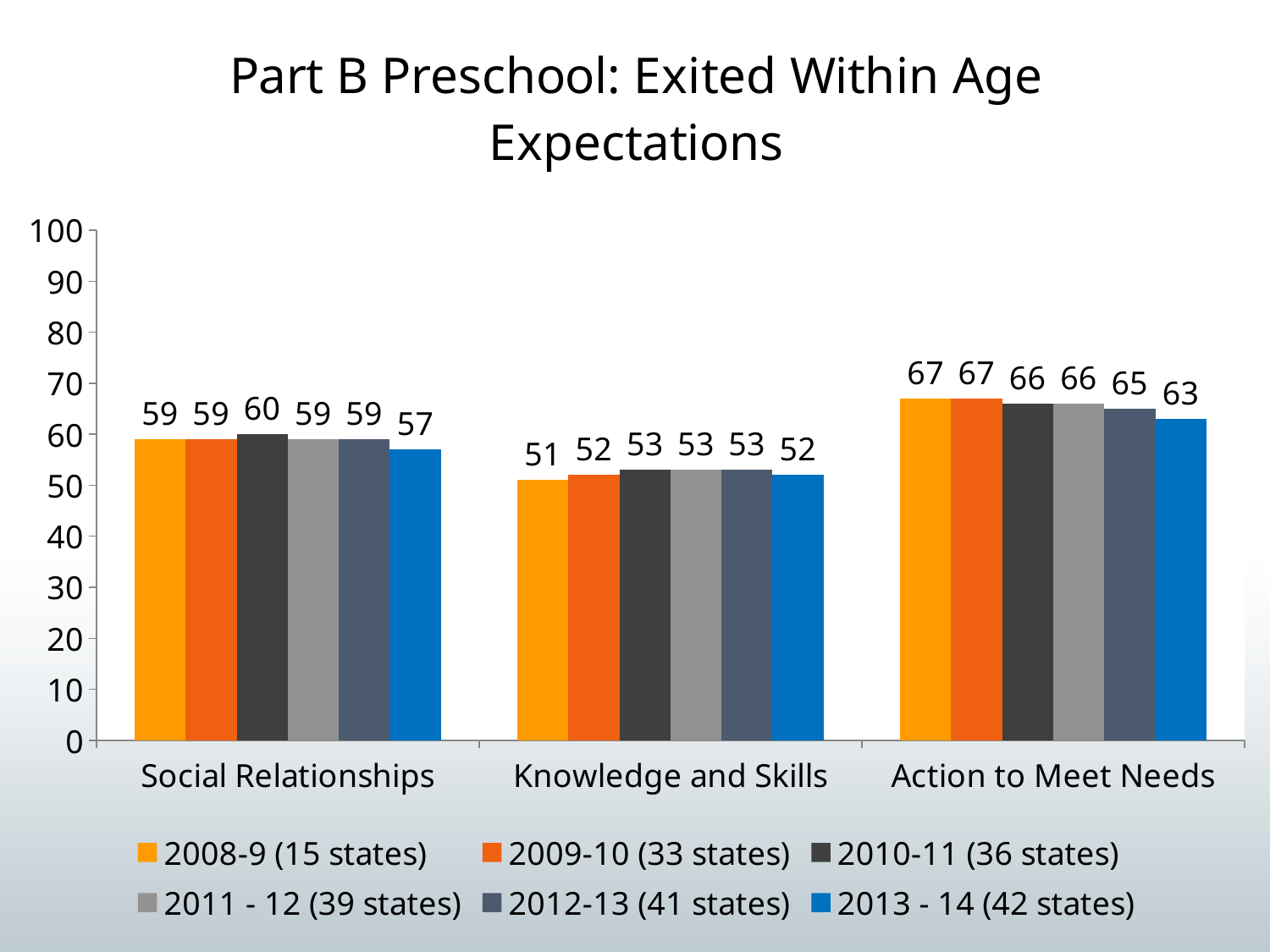
What is the title of the chart? Part B Preschool: Exited Within Age Expectations How many series does the legend list? 6 What kind of chart is shown on the slide? bar chart How many categories are shown on the x axis? 3 Which category has the highest value in the 2009-10 (33 states) series? Action to Meet Needs What is the value for Action to Meet Needs in the 2013 - 14 (42 states) series? 63 What is the difference between the 2008-9 (15 states) value and the 2013 - 14 (42 states) value for Action to Meet Needs? 4 Is the value for Knowledge and Skills in the 2011 - 12 (39 states) series greater or less than 60? less What is the value for Social Relationships in the 2010-11 (36 states) series? 60 Which is larger for Social Relationships: the 2010-11 (36 states) value or the 2013 - 14 (42 states) value? 2010-11 (36 states) What is the value for Knowledge and Skills in the 2008-9 (15 states) series? 51 Which category has the lowest value in the 2012-13 (41 states) series? Knowledge and Skills